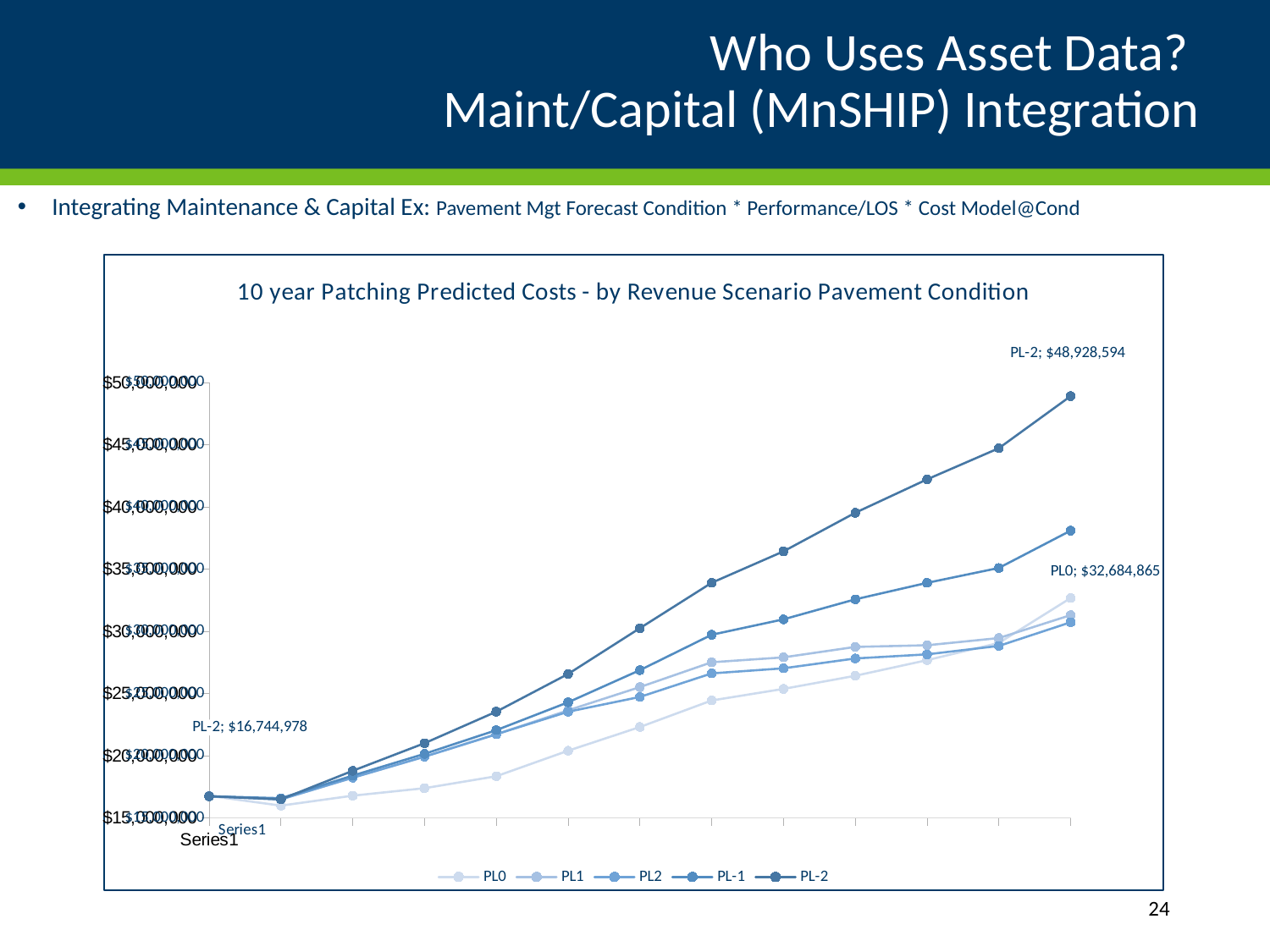
Do the predicted costs rise or fall over the forecast period? rise What kind of chart is shown on the slide? line chart What is the difference between the final labelled values of PL-2 and PL0? $16,243,729 By how much does the PL-2 series increase from its labelled starting value to its labelled final value? $32,183,616 What is the title of the chart? 10 year Patching Predicted Costs - by Revenue Scenario Pavement Condition What is the final labelled value for the PL0 series? $32,684,865 What is the starting labelled value for the PL-2 series? $16,744,978 How many series does the chart legend list? 5 What is the final labelled value for the PL-2 series? $48,928,594 Is the final value of the PL2 series greater or less than $35,000,000? less Which series reaches the highest value at the end of the chart? PL-2 At the end of the forecast, which series has the larger value, PL-2 or PL0? PL-2